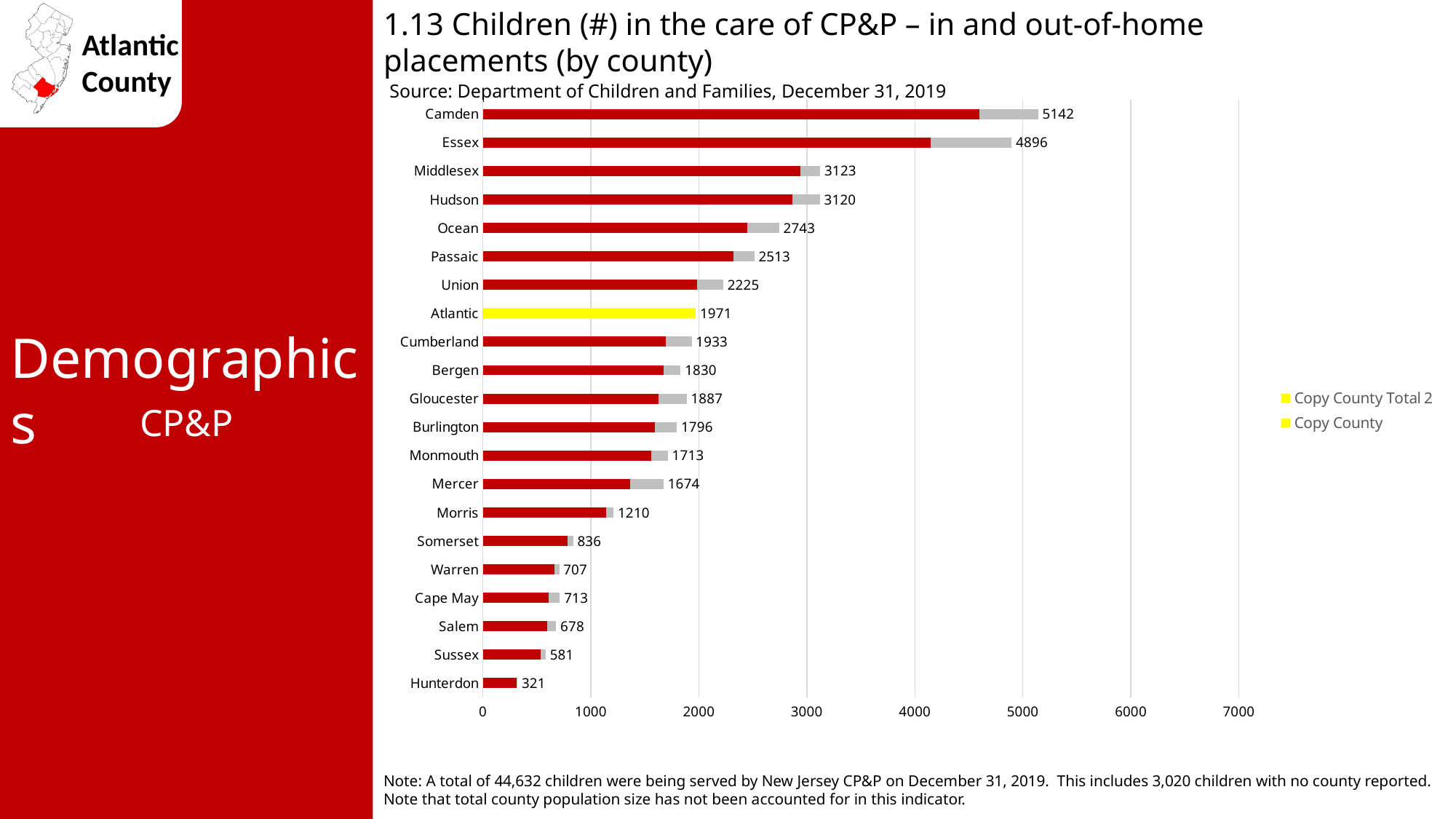
What is the difference between the totals for Camden and Essex? 246 Which county has the lowest total? Hunterdon Which county's bar is highlighted in yellow? Atlantic What is the total value shown for Hunterdon? 321 What is the total value shown for Atlantic? 1971 How many counties are shown on the chart? 21 Which has a larger total, Ocean or Passaic? Ocean What kind of chart is shown on the slide? Bar chart How many entries does the legend list? 2 Is the total for Union greater or less than 2000? greater Which county has the highest total? Camden What is the total number of children in the care of CP&P for Camden? 5142